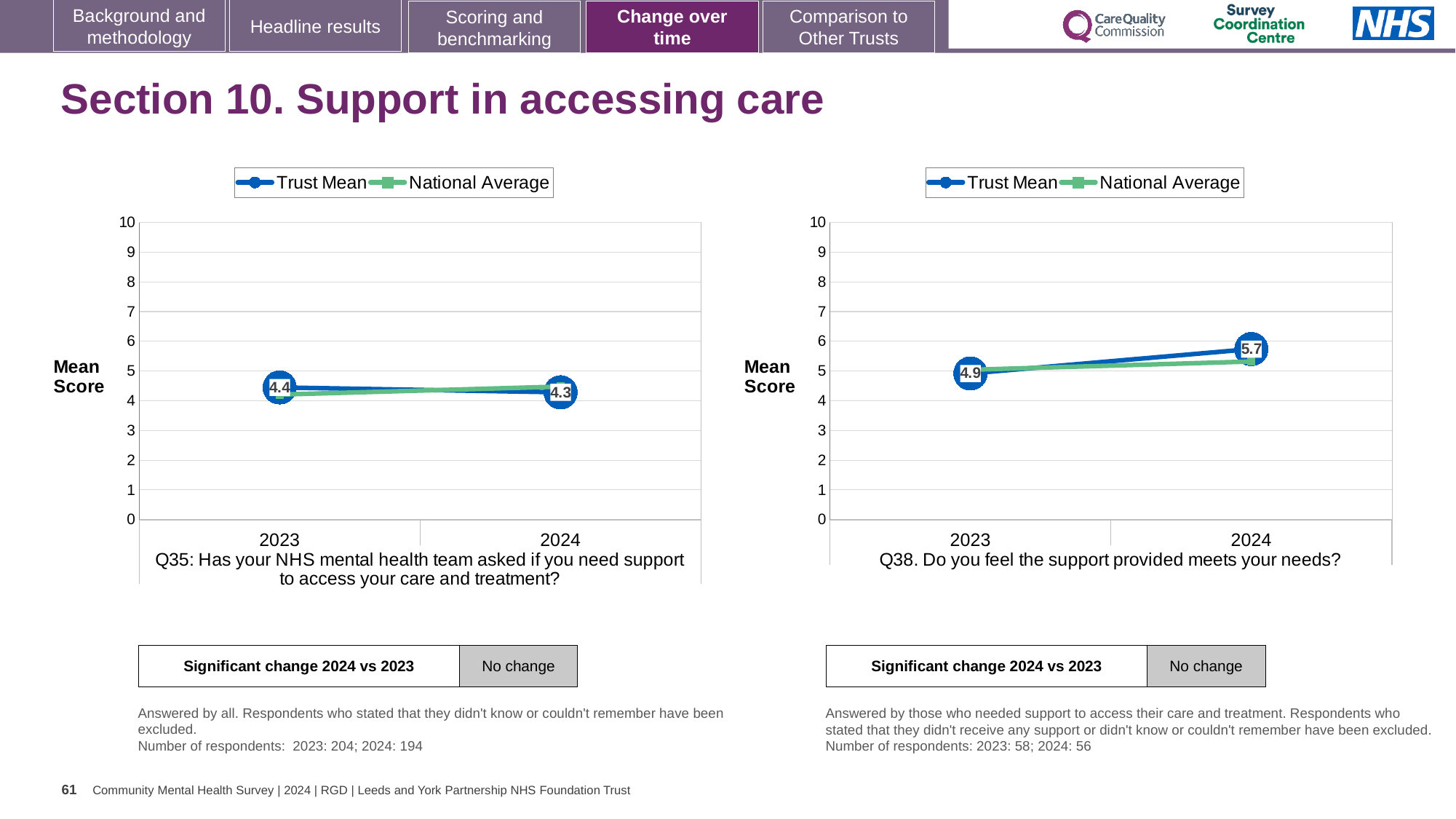
In the Q35 chart on the left, is the National Average value for 2024 greater or less than 6? less What type of chart is used for Q35 on the left? line chart How many years are plotted on the x axis of the Q35 chart on the left? 2 In the Q38 chart on the right, by how much did the Trust Mean change from 2023 to 2024? 0.8 How many series does the legend of the Q38 chart on the right list? 2 In the Q35 chart on the left, what is the Trust Mean score for 2023? 4.4 In the Q35 chart on the left, what is the Trust Mean score for 2024? 4.3 In the Q38 chart on the right, does the Trust Mean rise or fall from 2023 to 2024? rise In the Q38 chart on the right, what is the Trust Mean score for 2024? 5.7 In the Q35 chart on the left, does the Trust Mean rise or fall from 2023 to 2024? fall In the Q38 chart on the right, what is the Trust Mean score for 2023? 4.9 In the Q38 chart on the right, which year has the higher Trust Mean score? 2024